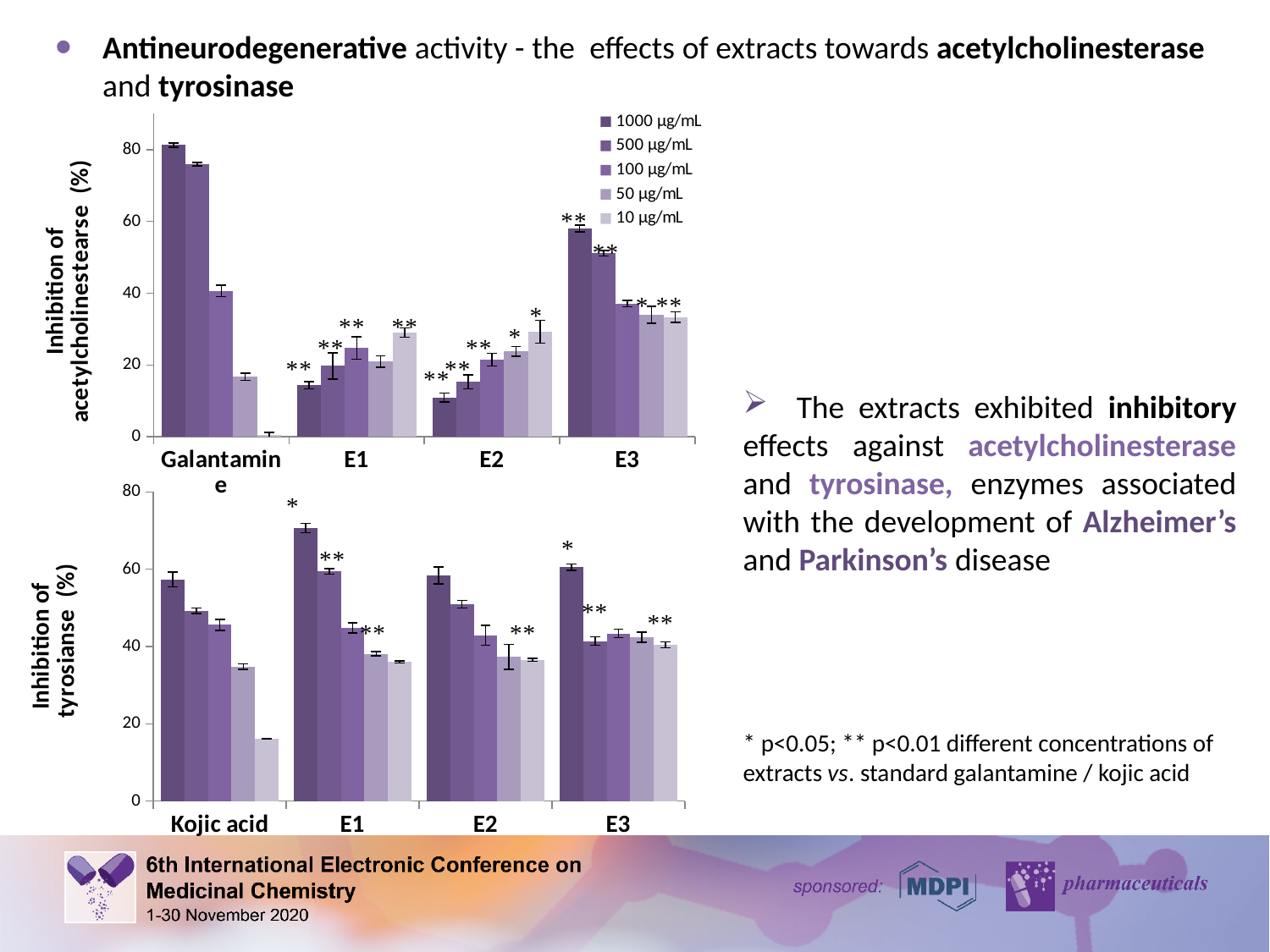
What is the label of the y axis of the bottom chart? Inhibition of tyrosianse (%) What type of chart is the top chart showing inhibition of acetylcholinesterase? bar chart In the bottom chart (inhibition of tyrosinase), which category has the highest bar? E1 In the top chart (inhibition of acetylcholinesterase), which category has the highest bar? Galantamine In the bottom chart (inhibition of tyrosinase), is the value for E1 at 1000 µg/mL greater or less than 60? greater How many series does the legend of the top chart list? 5 In the top chart (inhibition of acetylcholinesterase), is the value for Galantamine at 1000 µg/mL greater or less than 60? greater In the top chart (inhibition of acetylcholinesterase), is the value for E2 at 1000 µg/mL greater or less than 20? less How many categories are shown on the x axis of the bottom chart (inhibition of tyrosinase)? 4 In the top chart (inhibition of acetylcholinesterase), which is larger at 1000 µg/mL: E1 or E3? E3 In the bottom chart (inhibition of tyrosinase), which is larger at 10 µg/mL: Kojic acid or E1? E1